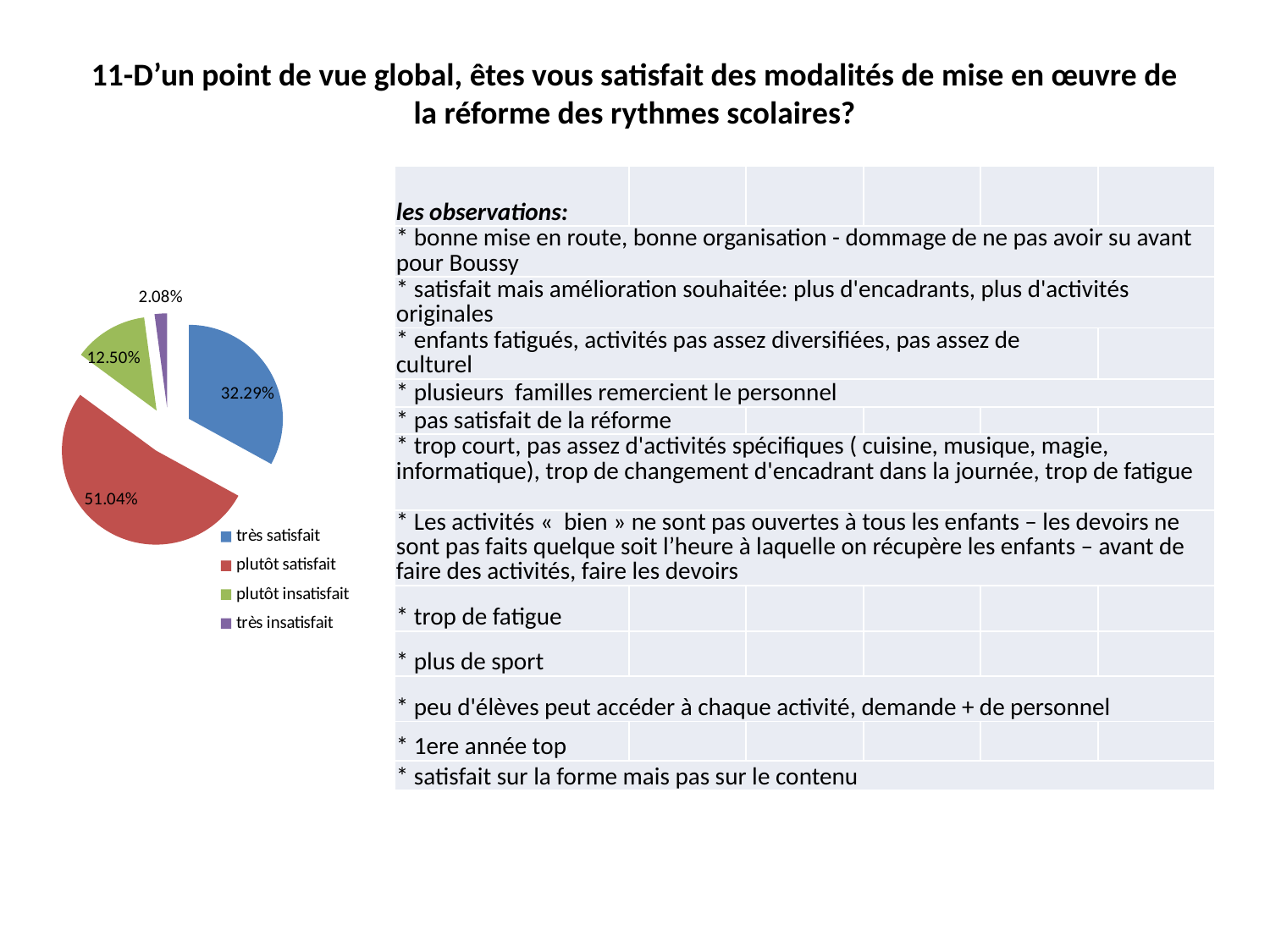
Which category has the smallest slice of the pie chart? très insatisfait What percentage of the pie chart is labelled "très insatisfait"? 2.08% How many slices does the pie chart have? 4 Which category has the largest slice of the pie chart? plutôt satisfait What percentage of the pie chart is labelled "plutôt satisfait"? 51.04% How many entries does the legend of the pie chart list? 4 What kind of chart is shown on the slide? pie chart What colour is the "plutôt satisfait" slice in the pie chart? red What percentage of the pie chart is labelled "très satisfait"? 32.29% What is the difference in percentage points between the "plutôt satisfait" and "très satisfait" slices? 18.75 What percentage of the pie chart is labelled "plutôt insatisfait"? 12.50% Which slice is larger in the pie chart: "très satisfait" or "plutôt insatisfait"? très satisfait